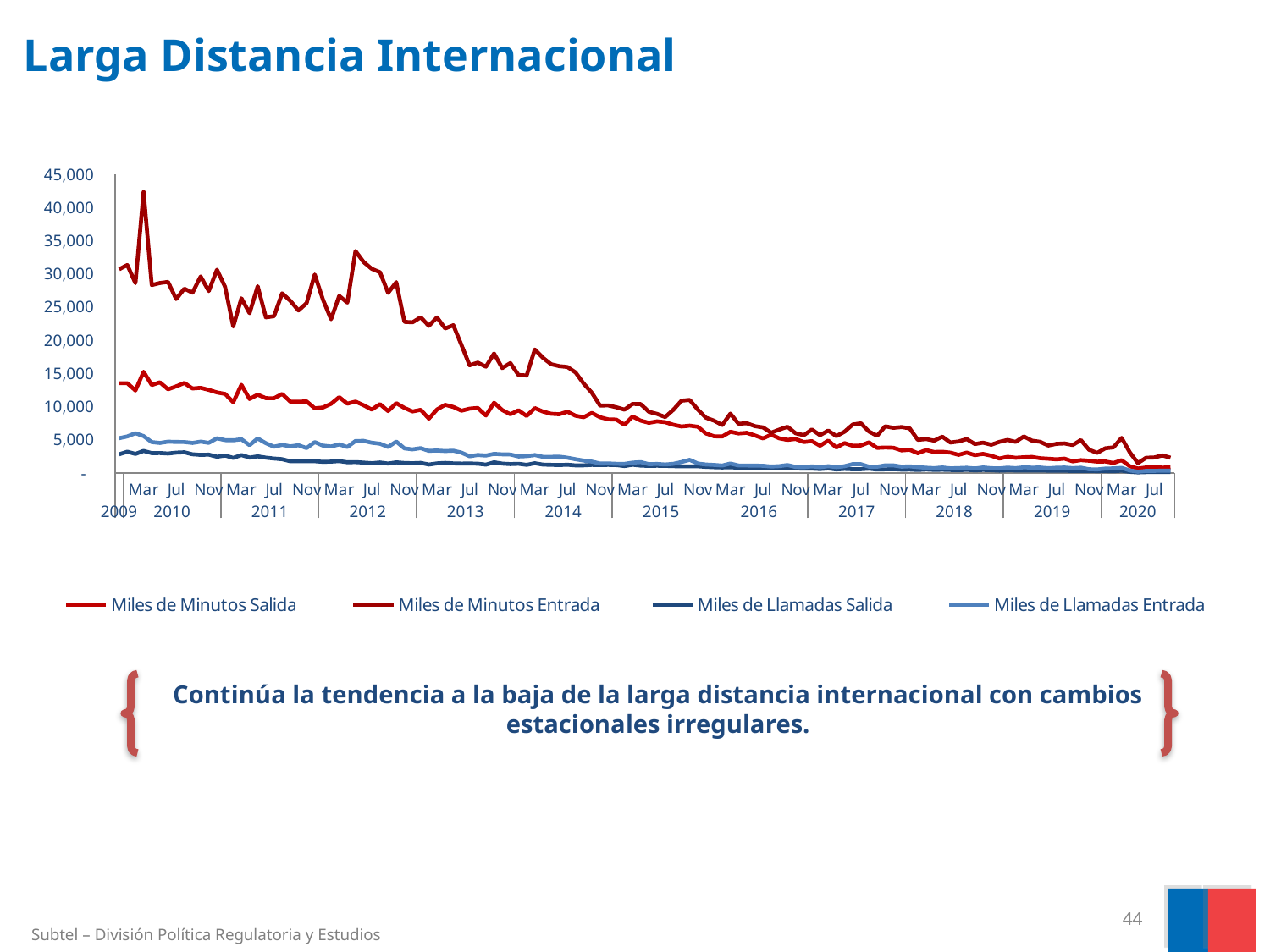
In 2009, is the value for Miles de Llamadas Entrada greater or less than 10,000? less How many years are labelled along the x axis? 12 What is the last year labelled on the x axis? 2020 Is the highest peak reached by any line in 2009 greater or less than 40,000? less What kind of chart is shown on the slide? Line chart How many series does the legend list? 4 Do the plotted values generally rise or fall from 2009 to 2020? Fall What is the title of the slide containing the chart? Larga Distancia Internacional In Jul 2020, is the value of the highest line greater or less than 5,000? less Are the Miles de Minutos lines higher or lower than the Miles de Llamadas lines throughout the chart? Higher What is the highest value shown on the y axis? 45,000